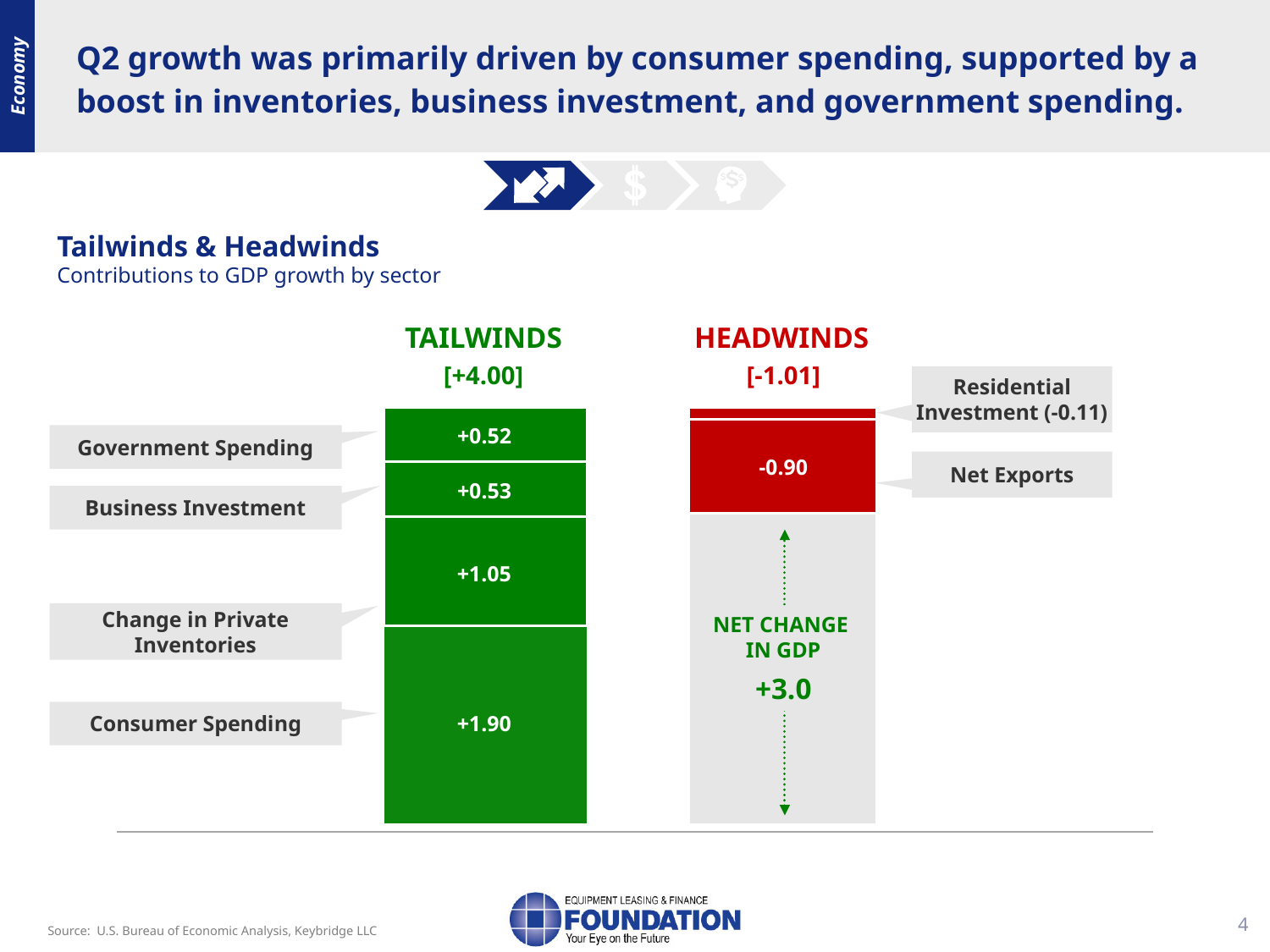
What is the difference between the Consumer Spending contribution and the Change in Private Inventories contribution? 0.85 What is the contribution of Net Exports to GDP growth? -0.90 What is the net change in GDP shown on the chart? +3.0 What is the total contribution of the Headwinds bar? -1.01 Which tailwind sector contributes the least to GDP growth? Government Spending How many sectors are shown in the Tailwinds bar? 4 Which is larger in magnitude: the Net Exports contribution or the Business Investment contribution? Net Exports What is the total contribution of the Tailwinds bar? +4.00 Which tailwind sector contributes the most to GDP growth? Consumer Spending What is the contribution of Residential Investment to GDP growth? -0.11 What is the contribution of Consumer Spending to GDP growth in the Tailwinds & Headwinds chart? +1.90 What is the contribution of Government Spending to GDP growth? +0.52